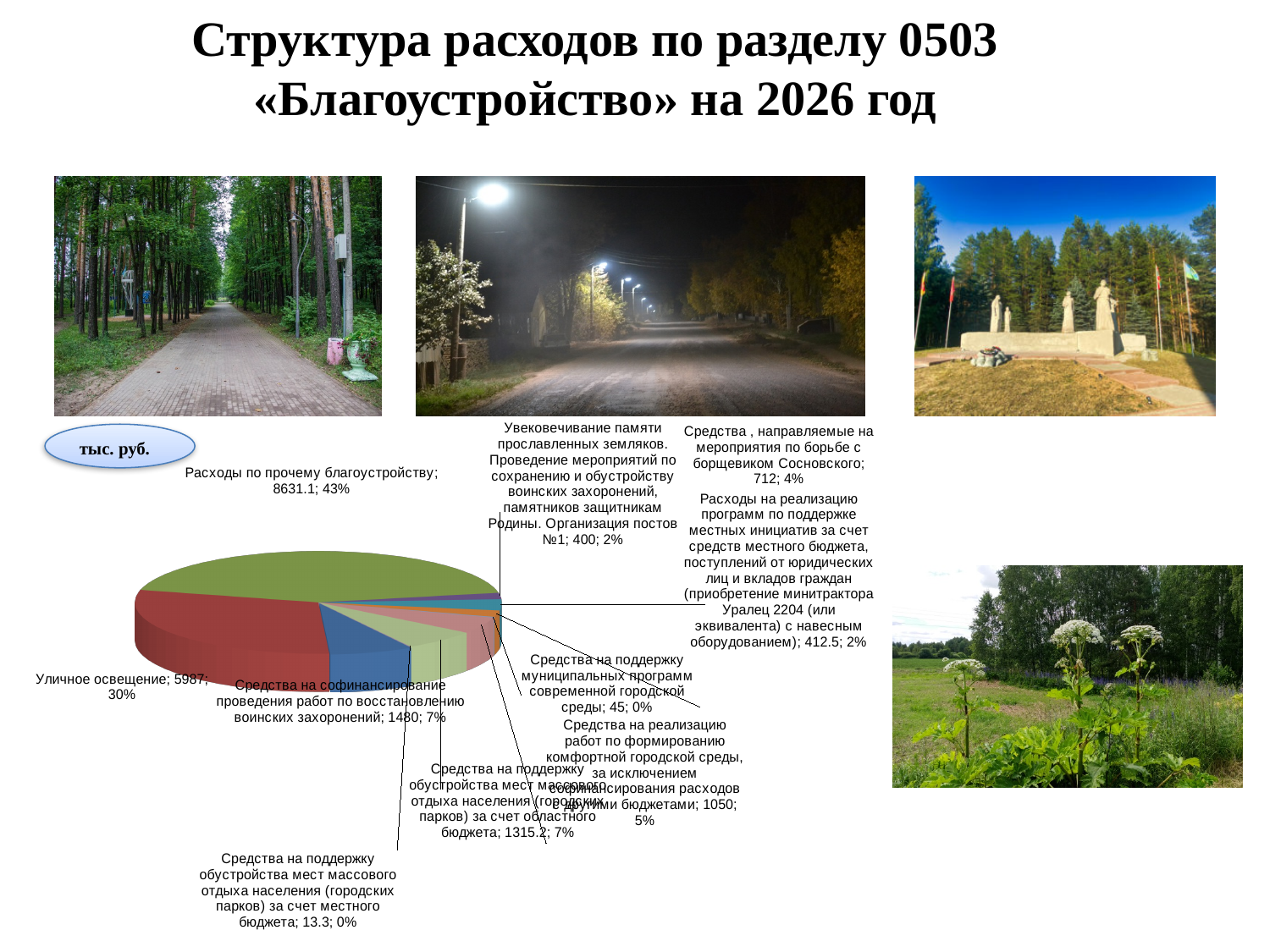
What is the value for «Средства, направляемые на мероприятия по борьбе с борщевиком Сосновского»? 712 Which category has the smallest value in the pie chart? Средства на поддержку обустройства мест массового отдыха населения (городских парков) за счет местного бюджета How many categories (slices) does the pie chart show? 10 What share of the pie does «Уличное освещение» represent? 30% What is the value for «Средства на поддержку муниципальных программ современной городской среды»? 45 What share of the pie does «Расходы по прочему благоустройству» represent? 43% What type of chart is shown on the slide? pie chart In what units are the values of the chart given, according to the slide? тыс. руб. Which category has the largest share of the pie chart? Расходы по прочему благоустройству Which is larger: the value for «Средства на софинансирование проведения работ по восстановлению воинских захоронений» or for «Средства на реализацию работ по формированию комфортной городской среды, за исключением софинансирования расходов с другими бюджетами»? Средства на софинансирование проведения работ по восстановлению воинских захоронений What is the value for «Уличное освещение»? 5987 What is the difference between the values for «Расходы по прочему благоустройству» and «Уличное освещение»? 2644.1